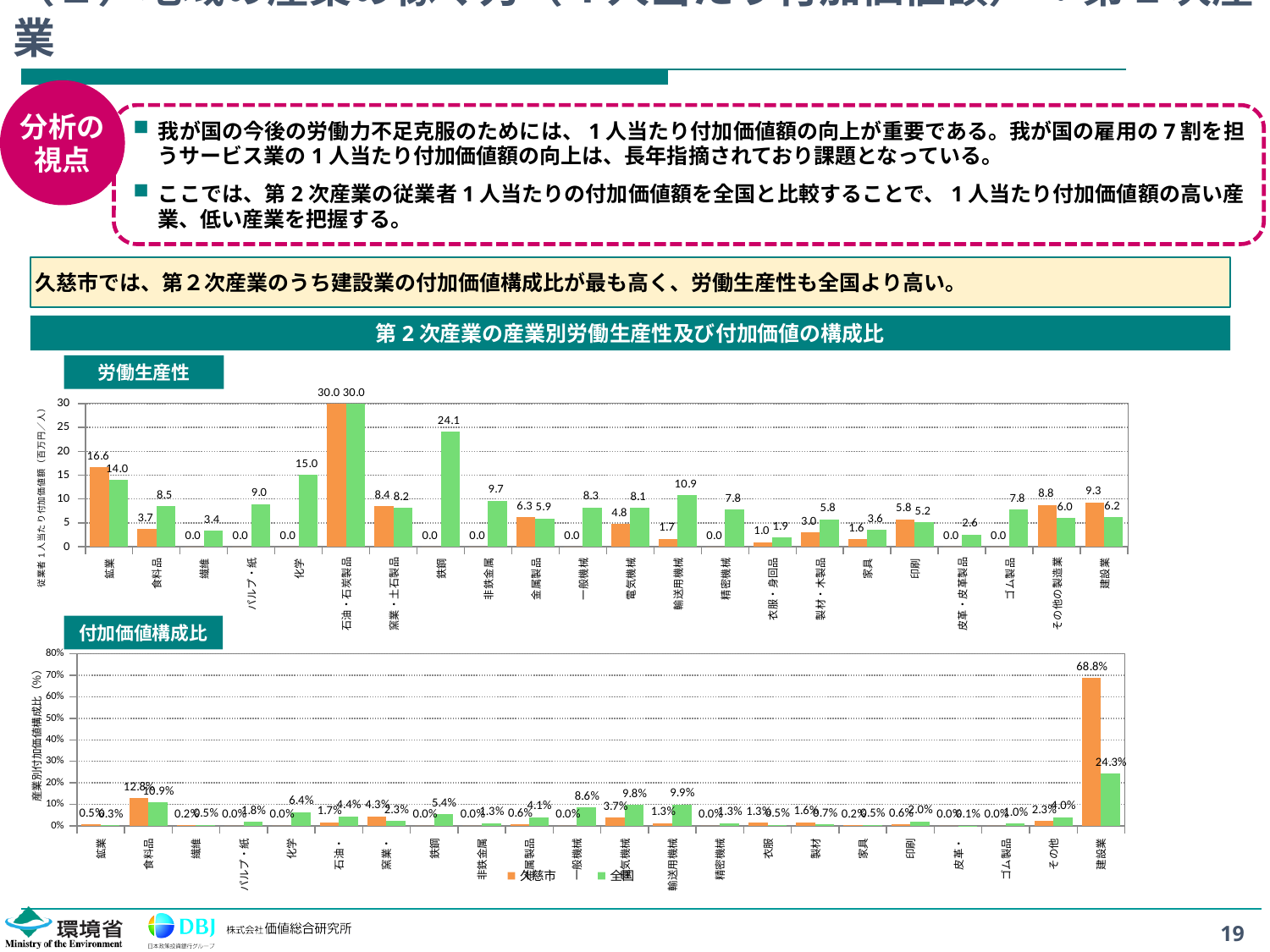
In the 付加価値構成比 chart, what is the value for 全国 in 電気機械? 9.8% In the 労働生産性 chart, which is larger in 鉱業, 久慈市 or 全国? 久慈市 In the 付加価値構成比 chart, what is the difference between 久慈市 and 全国 in 食料品? 1.9% In the 労働生産性 chart, what is the difference between 全国 and 久慈市 in 輸送用機械? 9.2 What kind of chart is the 労働生産性 chart? Bar chart How many series does the legend list for the 付加価値構成比 chart? 2 In the 労働生産性 chart, what is the value for 久慈市 in 建設業? 9.3 In the 労働生産性 chart, what is the value for 全国 in 鉄鋼? 24.1 In the 付加価値構成比 chart, what is the value for 久慈市 in 建設業? 68.8% In the 労働生産性 chart, what is the value for 久慈市 in 鉄鋼? 0.0 In the 労働生産性 chart, which category has the highest value for 全国? 石油・石炭製品 In the 付加価値構成比 chart, which category has the highest value for 久慈市? 建設業